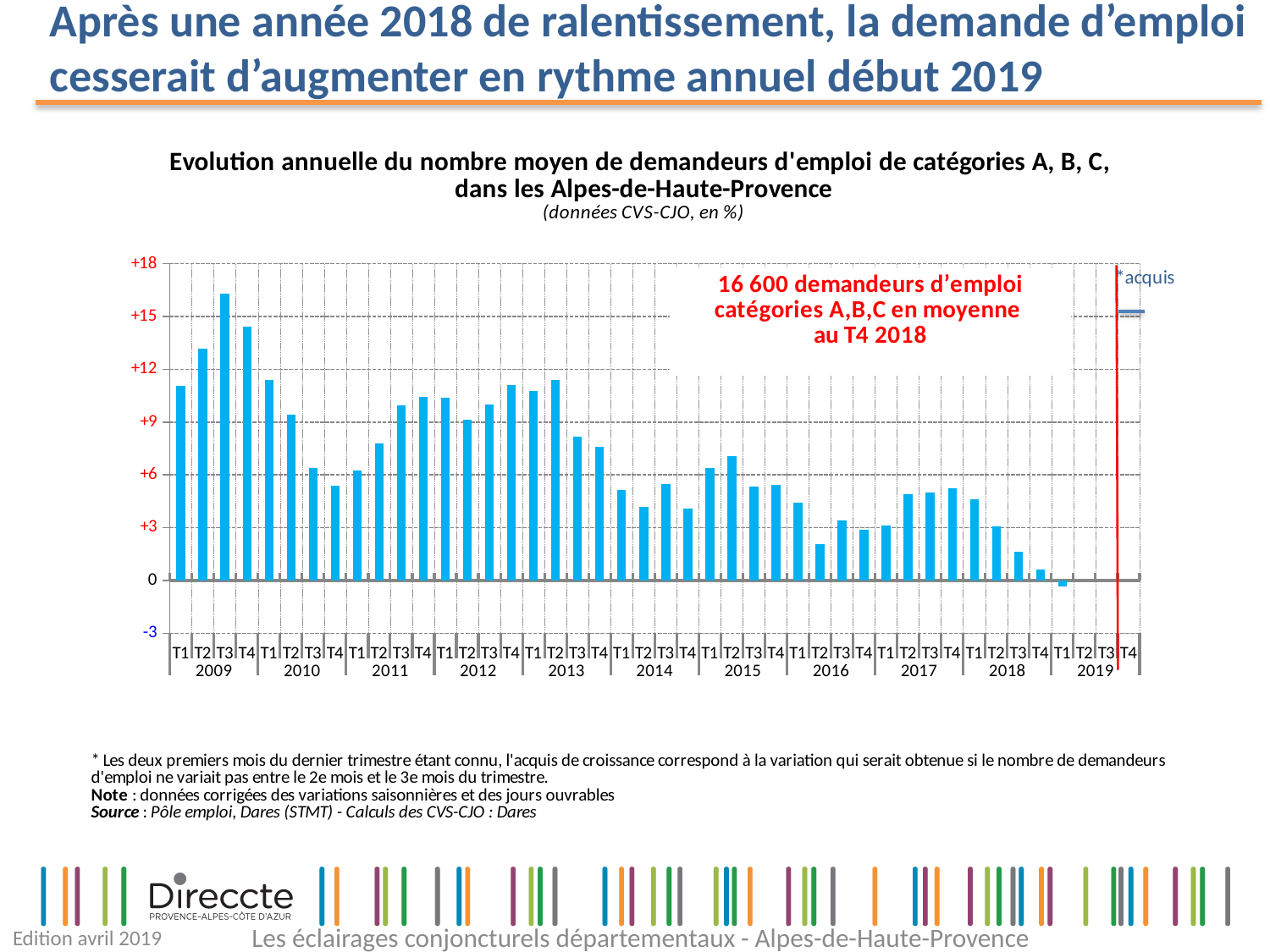
Is the value for T1 2013 greater or less than +9? greater Overall, do the values rise or fall from 2009 to 2019? fall Which is larger, the value for T1 2009 or the value for T1 2018? T1 2009 Is the value for T1 2019 greater or less than 0? less Is the value for T2 2016 greater or less than +3? less Which department does the chart cover, according to its title? Alpes-de-Haute-Provence Which quarter has the highest value in the chart? T3 2009 According to the annotation on the chart, how many demandeurs d'emploi of categories A, B, C were there on average in T4 2018? 16 600 Which quarter has the lowest value in the chart? T1 2019 What kind of chart is shown on the slide? bar chart